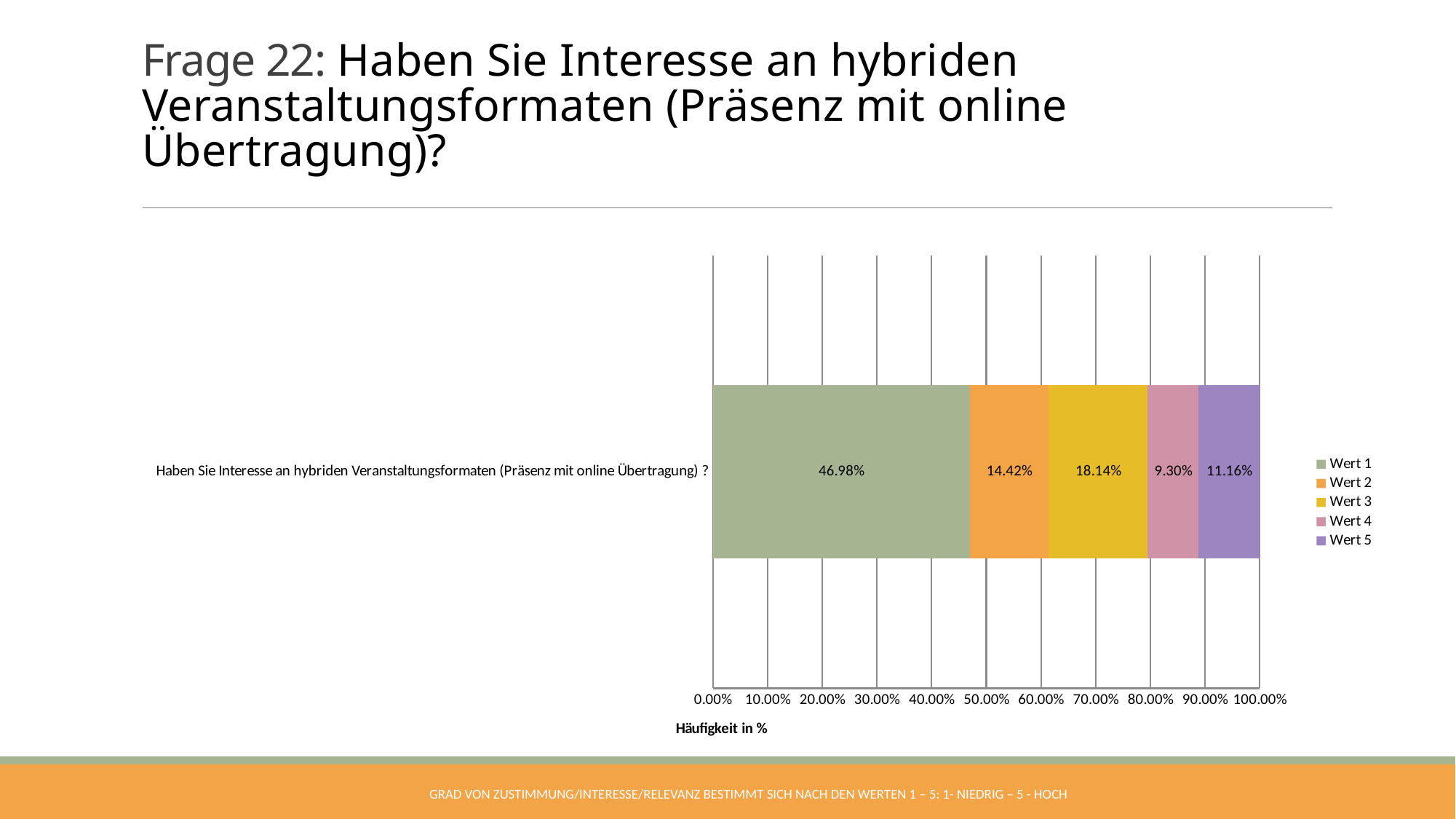
What is the value for Wert 3? 18.14% Which is larger, the value for Wert 2 or the value for Wert 5? Wert 2 How many series does the legend list? 5 What is the difference between the values for Wert 3 and Wert 2? 3.72% Which series has the lowest value? Wert 4 What is the value for Wert 1? 46.98% Which series has the highest value? Wert 1 What is the value for Wert 5? 11.16% What is the total of the stacked bar? 100.00% What kind of chart is shown on the slide? Stacked bar chart What colour is the segment for Wert 5? Purple What is the label of the x axis? Häufigkeit in %